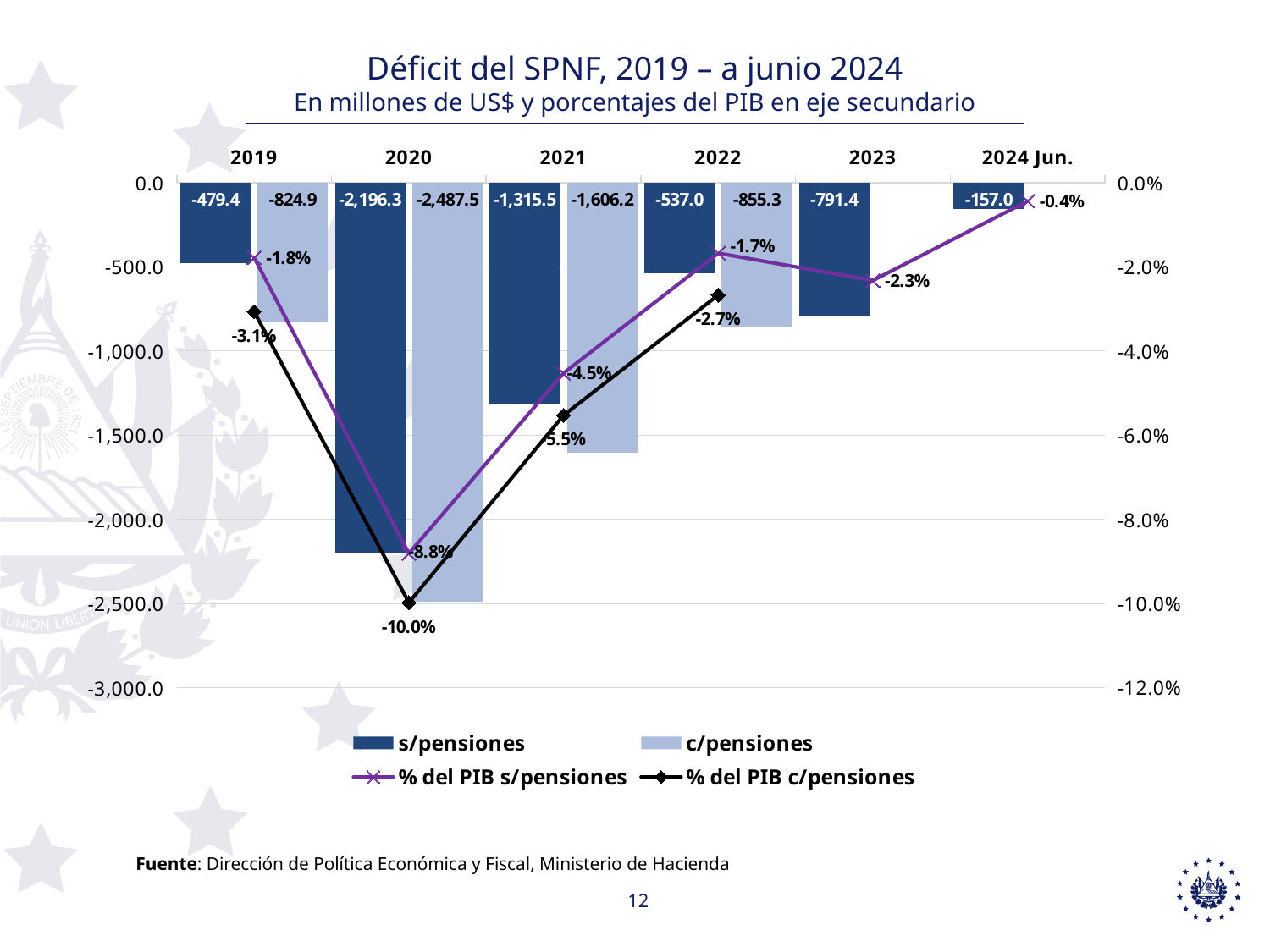
How many series does the legend list? 4 What is the % del PIB s/pensiones value for 2024 Jun.? -0.4% Which year has the lowest (most negative) s/pensiones value? 2020 How many categories are shown on the x axis? 6 What kind of chart is this? Bar and line chart Does the % del PIB s/pensiones line rise or fall from 2020 to 2024 Jun.? Rise Which year shows a larger s/pensiones deficit (more negative value), 2022 or 2023? 2023 What is the difference between the c/pensiones and s/pensiones values for 2019? 345.5 What is the % del PIB c/pensiones value for 2020? -10.0% Which category has the highest (closest to zero) s/pensiones value? 2024 Jun. What is the c/pensiones value for 2021? -1,606.2 What is the s/pensiones value for 2020? -2,196.3